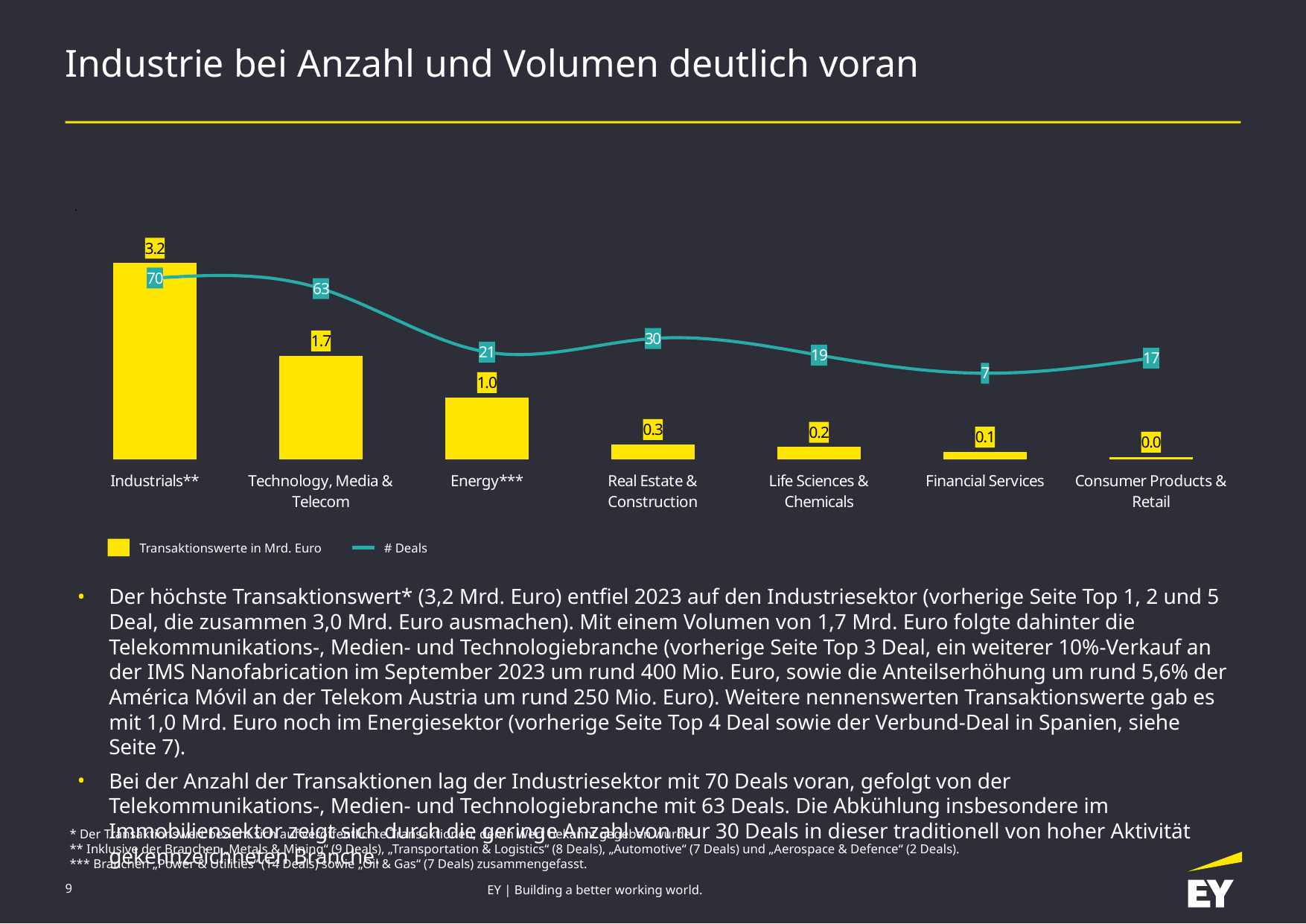
What is the legend label of the yellow bar series? Transaktionswerte in Mrd. Euro Which category has the highest transaction value? Industrials** Which has more deals, Energy or Real Estate & Construction? Real Estate & Construction How many deals are shown for Real Estate & Construction? 30 Which category has the lowest number of deals? Financial Services What is the transaction value for Consumer Products & Retail? 0.0 How many deals does the line series show for Technology, Media & Telecom? 63 What is the difference in number of deals between Industrials and Technology, Media & Telecom? 7 What is the transaction value in billion euros for Industrials? 3.2 How many series does the legend list? 2 What is the transaction value for Energy? 1.0 How many categories are shown on the x axis? 7